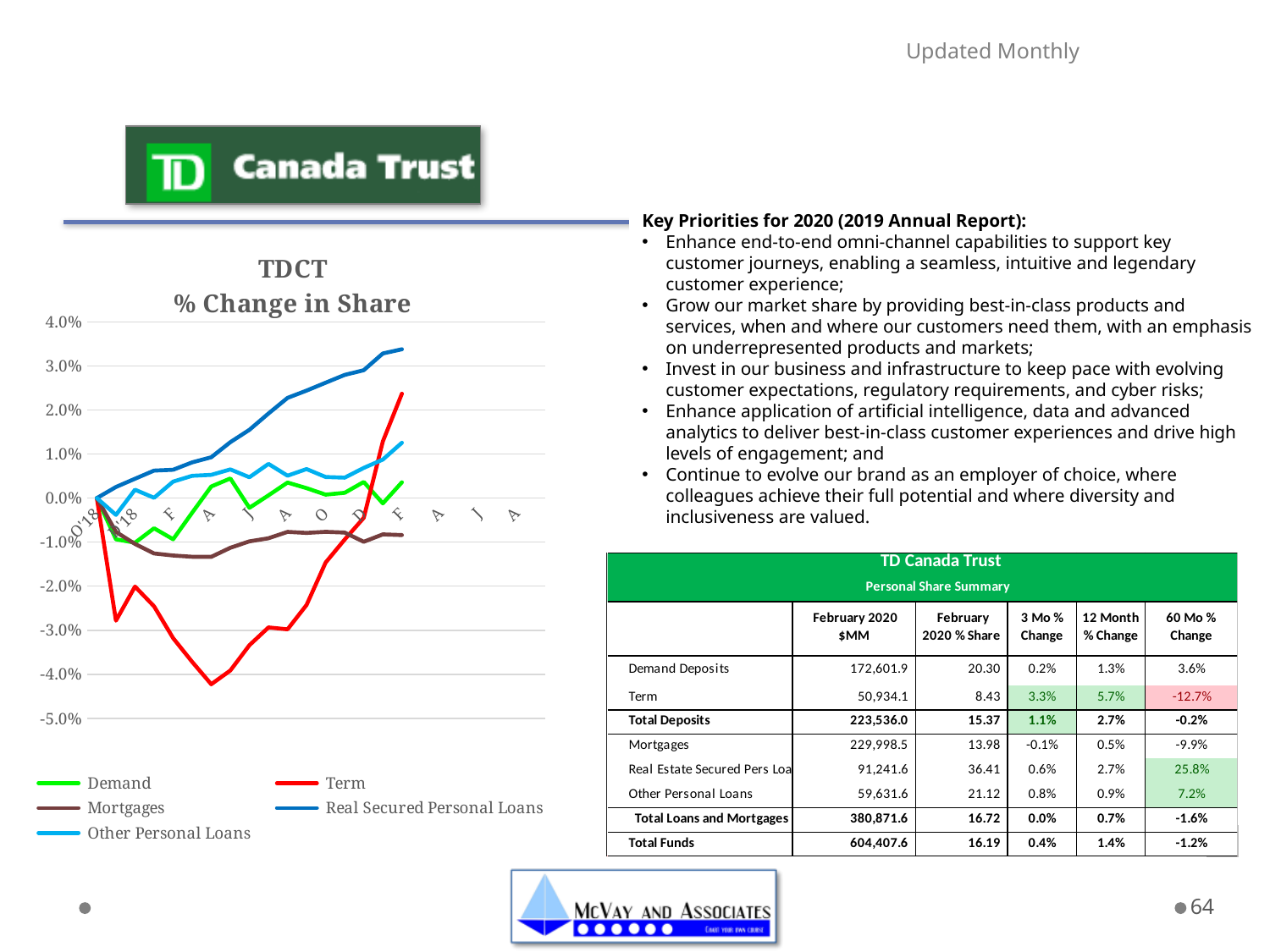
Is the final value of the Term series greater or less than 2.0%? greater Is the lowest value of the Mortgages series greater or less than -1.0%? less Which series reaches the lowest value on the TDCT % Change in Share chart? Term What is the title of the chart on the slide? TDCT % Change in Share Is the lowest value of the Term series greater or less than -3.0%? less At the end of the series, which is larger: Real Secured Personal Loans or Mortgages? Real Secured Personal Loans Does the Real Secured Personal Loans series generally rise or fall along the x axis? rise What kind of chart is shown on the slide? line chart Which colour is used for the Term series in the chart? red How many series does the legend of the TDCT % Change in Share chart list? 5 Which series reaches the highest value on the TDCT % Change in Share chart? Real Secured Personal Loans